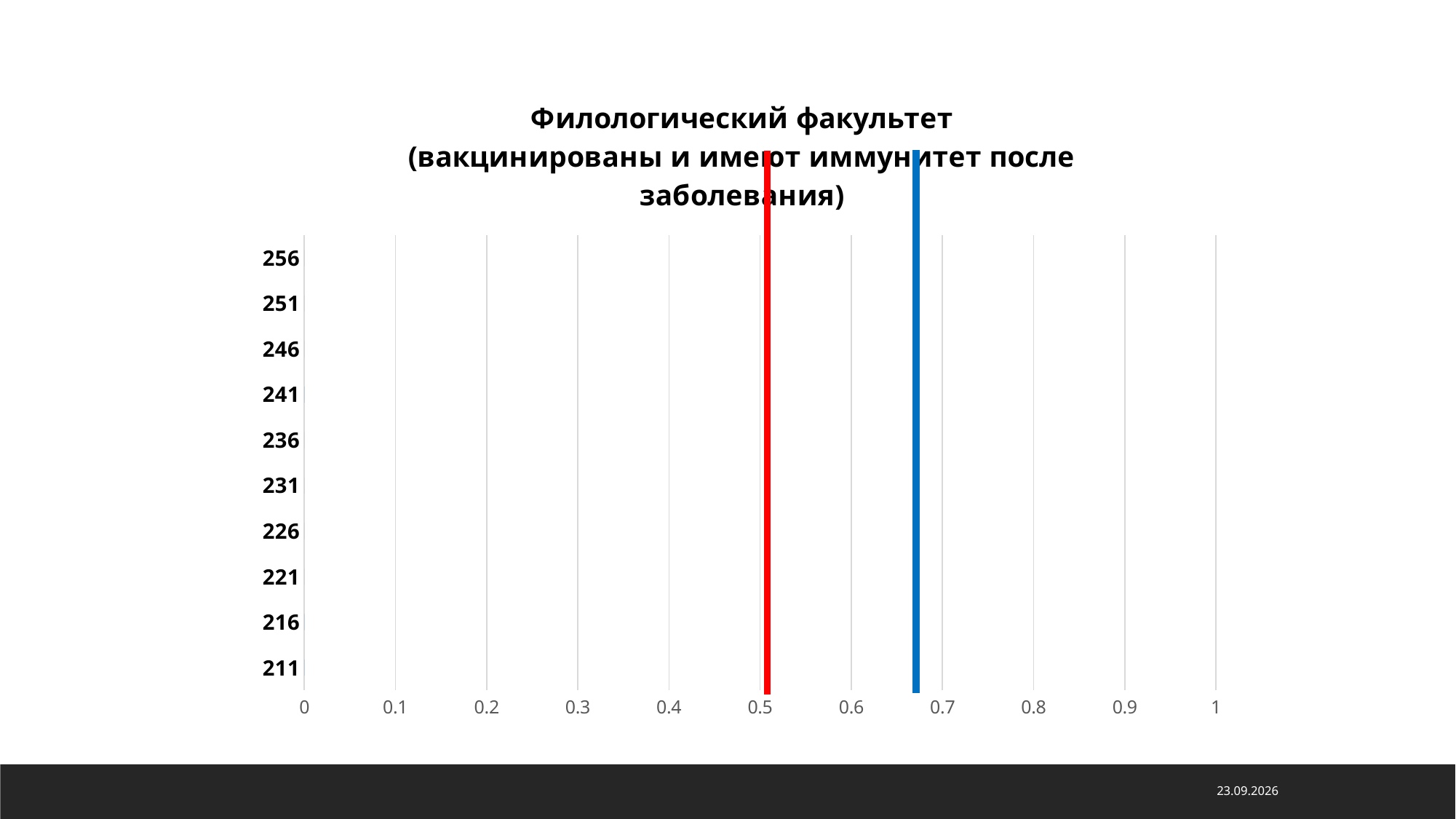
What is the lowest value labelled on the vertical axis? 211 Is the position of the blue line on the horizontal axis greater or less than 0.6? greater How many vertical lines are plotted on the chart? 2 Is the position of the red line on the horizontal axis greater or less than 0.4? greater Is the position of the red line on the horizontal axis greater or less than 0.6? less What is the highest value labelled on the vertical axis? 256 What is the maximum value shown on the horizontal axis? 1 How many labels are shown on the vertical axis of the chart? 10 Which line sits further to the right on the horizontal axis, the red line or the blue line? The blue line